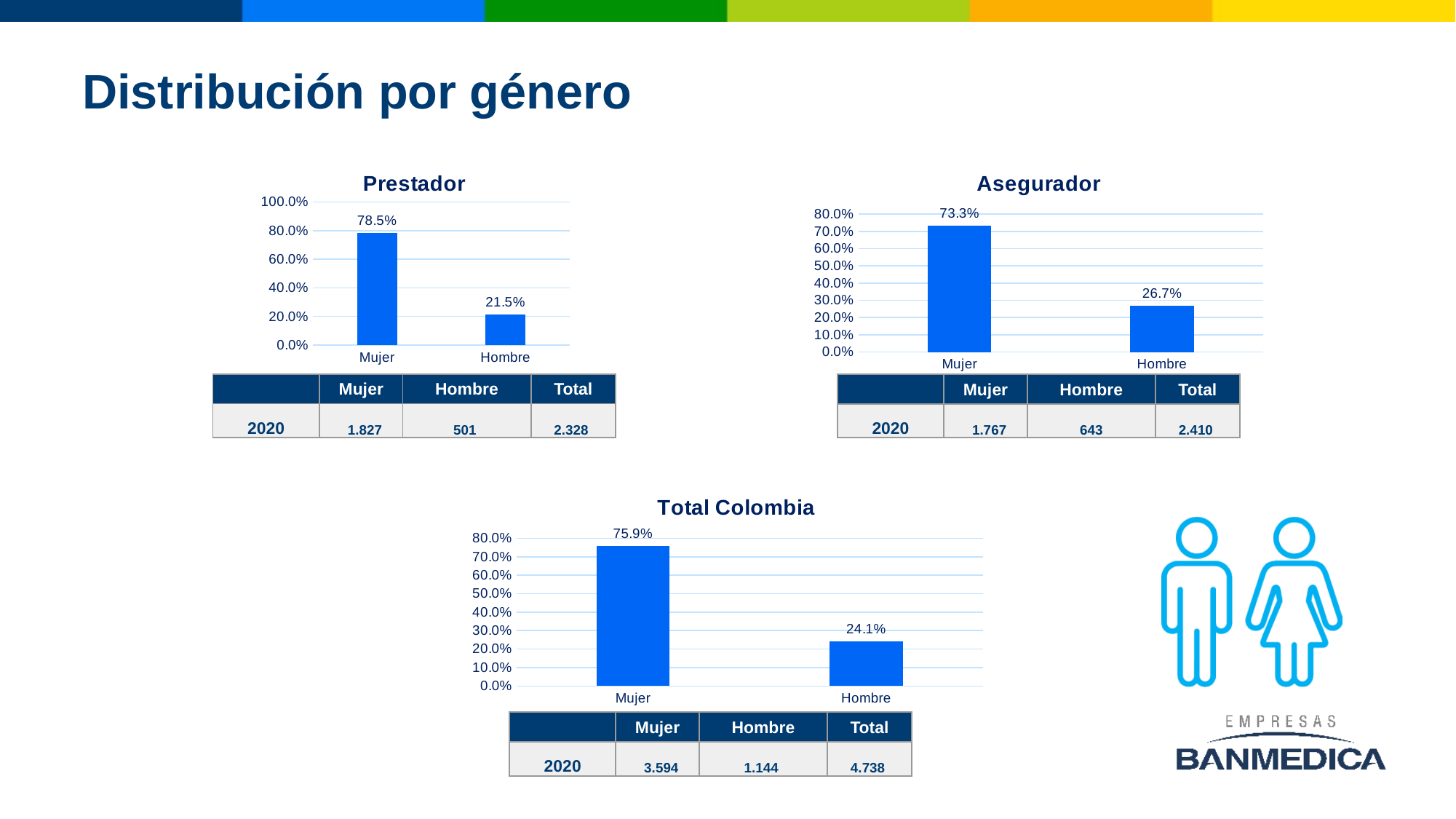
In the Asegurador chart, which category has the lowest value? Hombre In the Prestador chart, what is the value for Hombre? 21.5% In the Prestador chart, what is the difference between the Mujer and Hombre values? 57.0% What kind of chart is the Total Colombia chart? Bar chart In the Asegurador chart, what is the value for Mujer? 73.3% In the Prestador chart, what is the value for Mujer? 78.5% In the Total Colombia chart, what is the difference between the Mujer and Hombre values? 51.8% In the Total Colombia chart, which category has the highest value? Mujer How many categories are shown in the Prestador chart? 2 In the Asegurador chart, is the value for Mujer greater or less than 70.0%? greater In the Total Colombia chart, what is the value for Hombre? 24.1% In the Asegurador chart, what is the value for Hombre? 26.7%